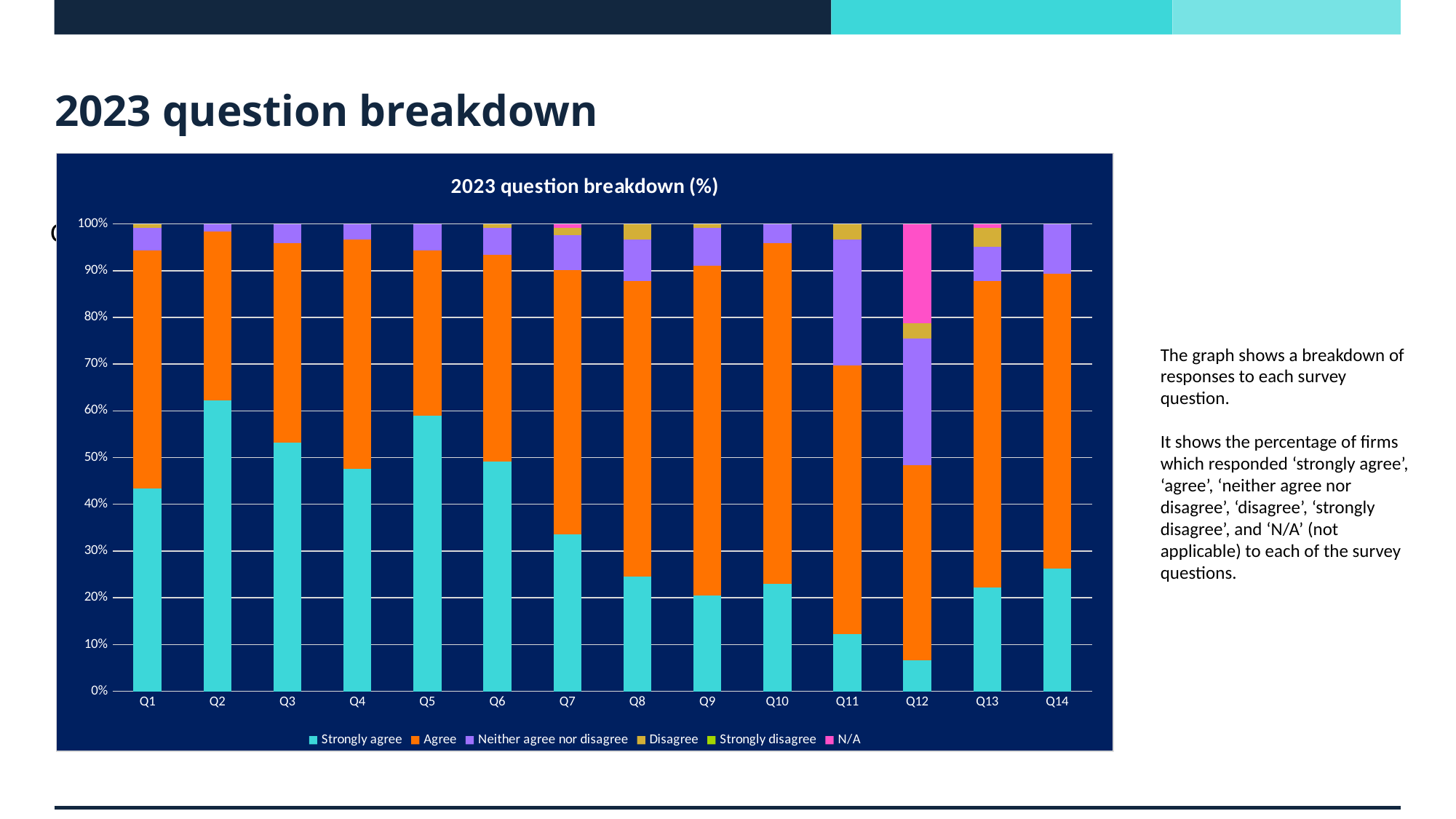
Which question has the lowest share of 'Strongly agree' responses? Q12 Is the 'Strongly agree' share for Q12 greater or less than 10%? less What is the title of the chart? 2023 question breakdown (%) How many series does the chart's legend list? 6 Is the 'Strongly agree' share for Q11 greater or less than 20%? less Which question has the highest share of 'Strongly agree' responses? Q2 Which has a larger 'Strongly agree' share, Q1 or Q9? Q1 What kind of chart is shown on the slide? Stacked bar chart Is the 'Strongly agree' share for Q7 greater or less than 30%? greater How many survey questions (categories) are shown on the x axis of the chart? 14